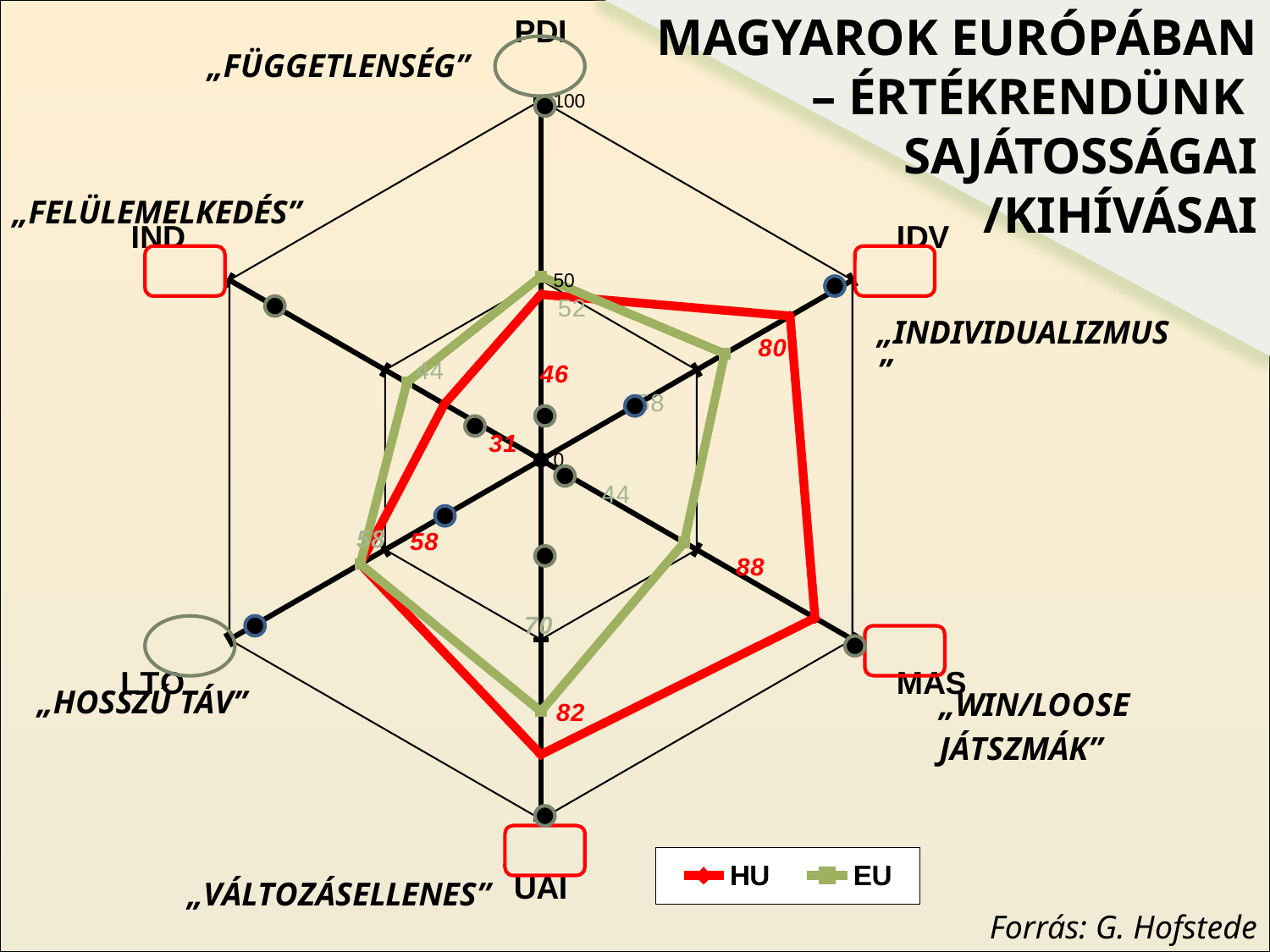
What is the EU value for UAI? 70 On which axis does the HU series have its lowest value? IND What is the HU value for IDV? 80 Which series has the larger value for UAI, HU or EU? HU What is the difference between the HU and EU values for MAS? 44 What is the EU value for PDI? 52 How many axes (categories) does the radar chart have? 6 How many series does the legend list? 2 What is the HU value for MAS? 88 On which axis does the HU series have its highest value? MAS What is the HU value for IND? 31 What kind of chart is shown on the slide? radar chart